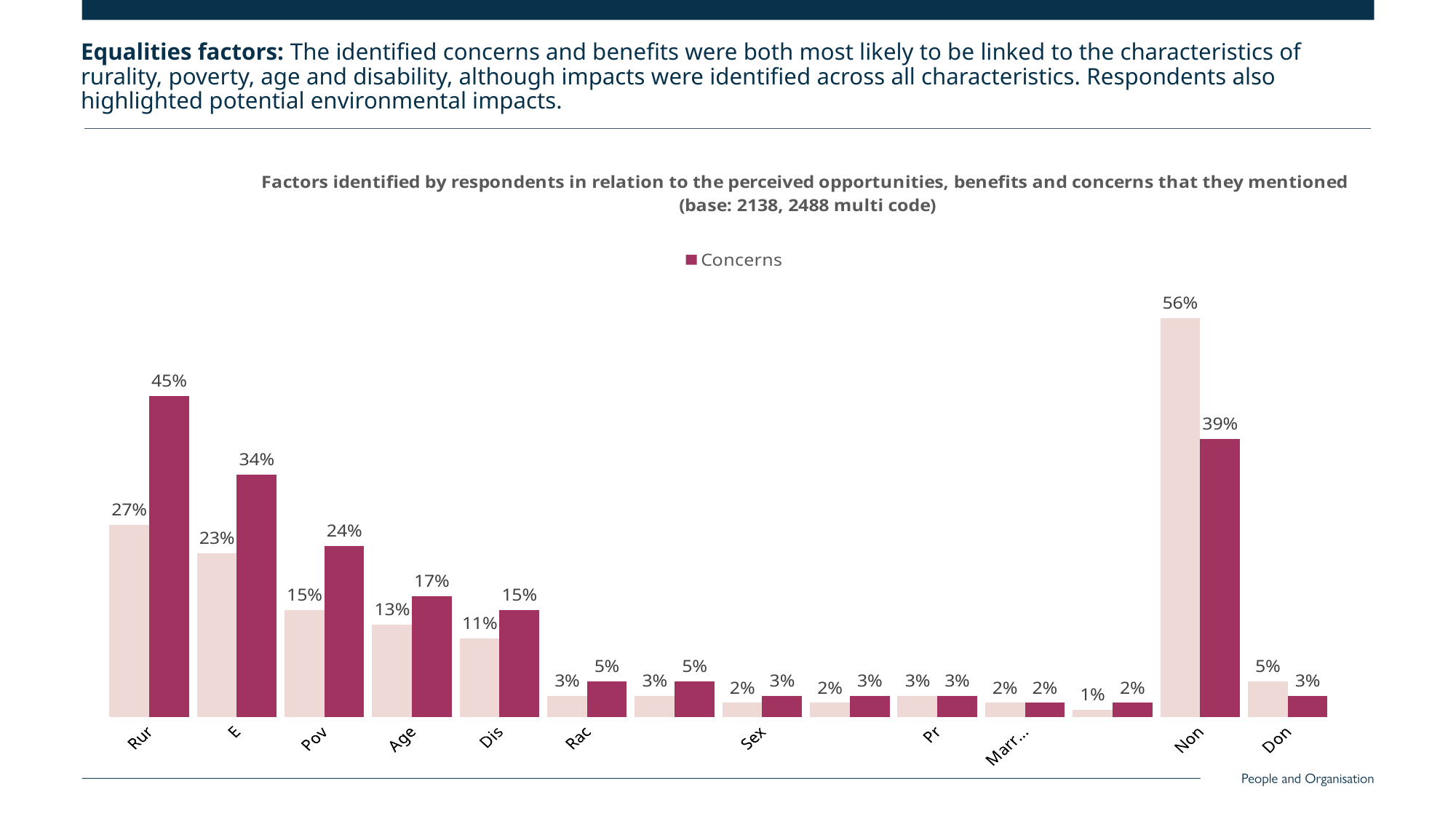
What kind of chart is shown on the slide? bar chart Which category has the highest Concerns value? Rur What is the difference between the Concerns values for Rur and E? 11% Which is larger: the Concerns value for Age or the Concerns value for Dis? Age What is the value of the lighter (pale pink) bar for Non? 56% Which series name is listed in the chart legend? Concerns What is the Concerns value for Rur? 45% Which category has the highest value for the lighter (pale pink) bars? Non What is the Concerns value for Pov? 24% For Non, which is larger: the lighter (pale pink) bar or the Concerns bar? the lighter (pale pink) bar What is the difference between the two bars shown for Non? 17% What is the Concerns value for Dis? 15%